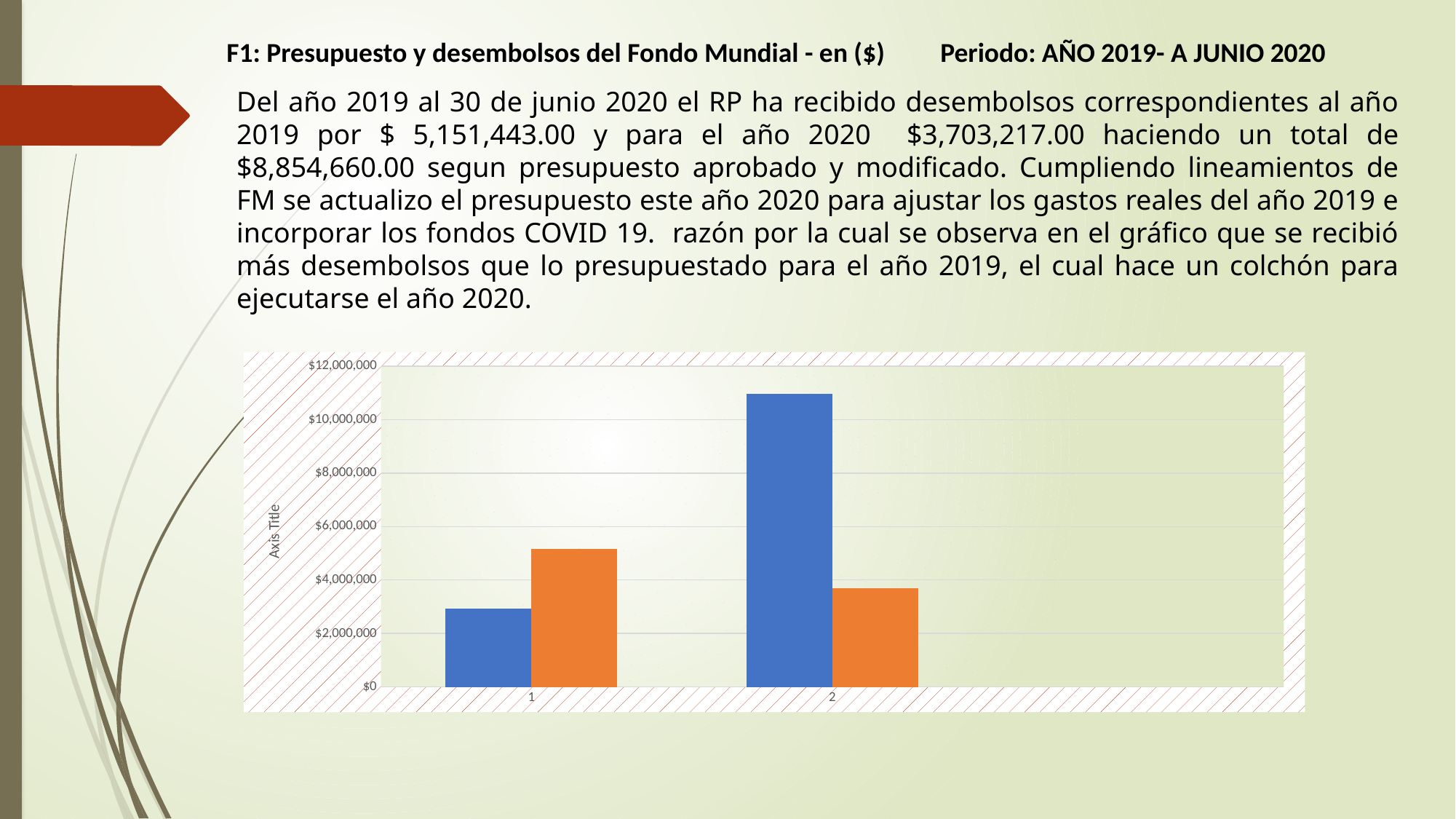
Which bar is the shortest in the chart? the blue bar for category 1 How many bars are plotted for category 1 in the chart? 2 How many categories are shown on the x axis of the chart? 2 Is the value of the blue bar for category 2 greater or less than $10,000,000? greater For category 2, which bar is taller, the blue one or the orange one? the blue one Is the value of the blue bar for category 1 greater or less than $4,000,000? less For category 1, which bar is taller, the blue one or the orange one? the orange one Which bar is the tallest in the chart? the blue bar for category 2 Is the value of the orange bar for category 1 greater or less than $4,000,000? greater What kind of chart is shown on the slide? bar chart What is the label shown on the vertical axis of the chart? Axis Title